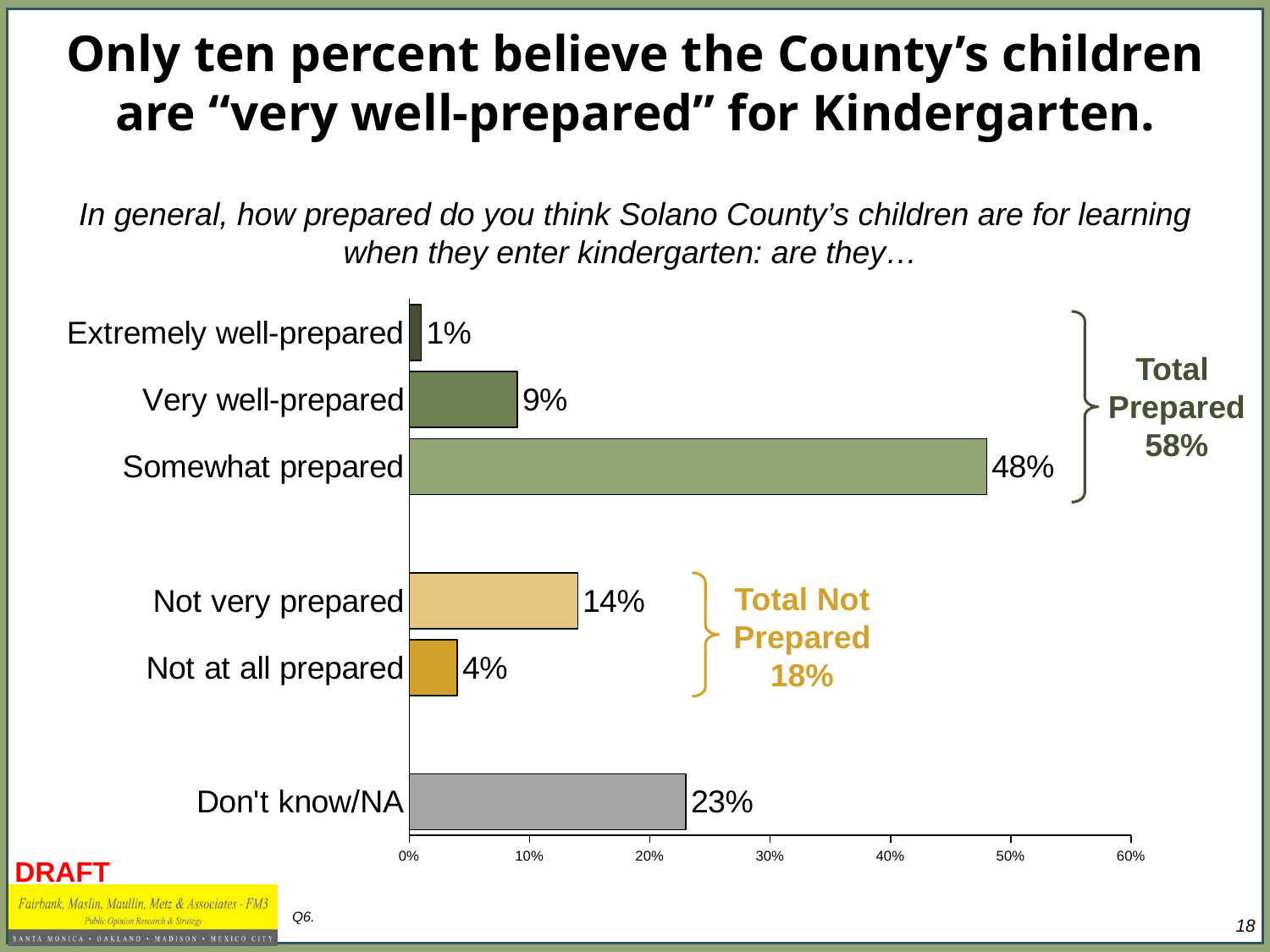
What kind of chart is shown on the slide? Bar chart What percentage answered "Don't know/NA"? 23% What is the difference between the "Somewhat prepared" and "Don't know/NA" values? 25% What is the "Total Not Prepared" percentage shown on the slide? 18% Which response category has the lowest value? Extremely well-prepared Which response category has the highest value? Somewhat prepared Which is larger, the value for "Very well-prepared" or the value for "Not at all prepared"? Very well-prepared What is the value shown for "Not very prepared"? 14% What is the "Total Prepared" percentage shown on the slide? 58% What percentage of respondents said the County's children are "Somewhat prepared" for kindergarten? 48% How many response categories are shown in the chart? 6 Is the value for "Somewhat prepared" greater or less than 40%? greater